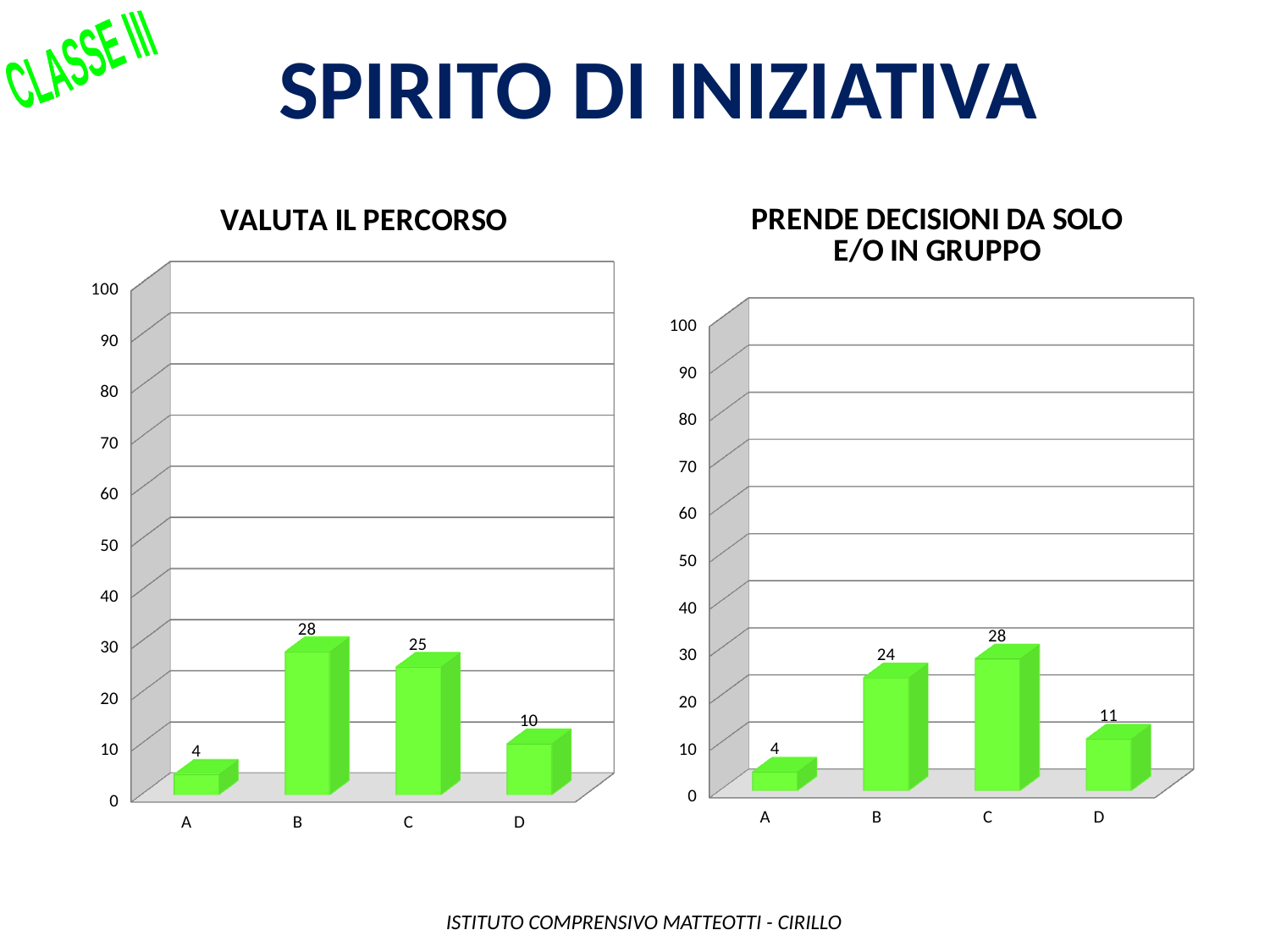
How many categories are shown in the 'VALUTA IL PERCORSO' chart? 4 In the 'VALUTA IL PERCORSO' chart, what is the difference between the values for B and C? 3 In the 'VALUTA IL PERCORSO' chart, what is the value for category B? 28 In the 'VALUTA IL PERCORSO' chart, is the value for C greater or less than 20? greater In the 'PRENDE DECISIONI DA SOLO E/O IN GRUPPO' chart, what is the difference between the values for C and D? 17 In the 'PRENDE DECISIONI DA SOLO E/O IN GRUPPO' chart, what is the value for category C? 28 In the 'VALUTA IL PERCORSO' chart, which category has the highest value? B In the 'PRENDE DECISIONI DA SOLO E/O IN GRUPPO' chart, which category has the lowest value? A In the 'PRENDE DECISIONI DA SOLO E/O IN GRUPPO' chart, which is larger, the value for B or the value for C? C What kind of chart is the 'PRENDE DECISIONI DA SOLO E/O IN GRUPPO' chart? bar chart In the 'PRENDE DECISIONI DA SOLO E/O IN GRUPPO' chart, what is the value for category A? 4 In the 'VALUTA IL PERCORSO' chart, what is the value for category D? 10